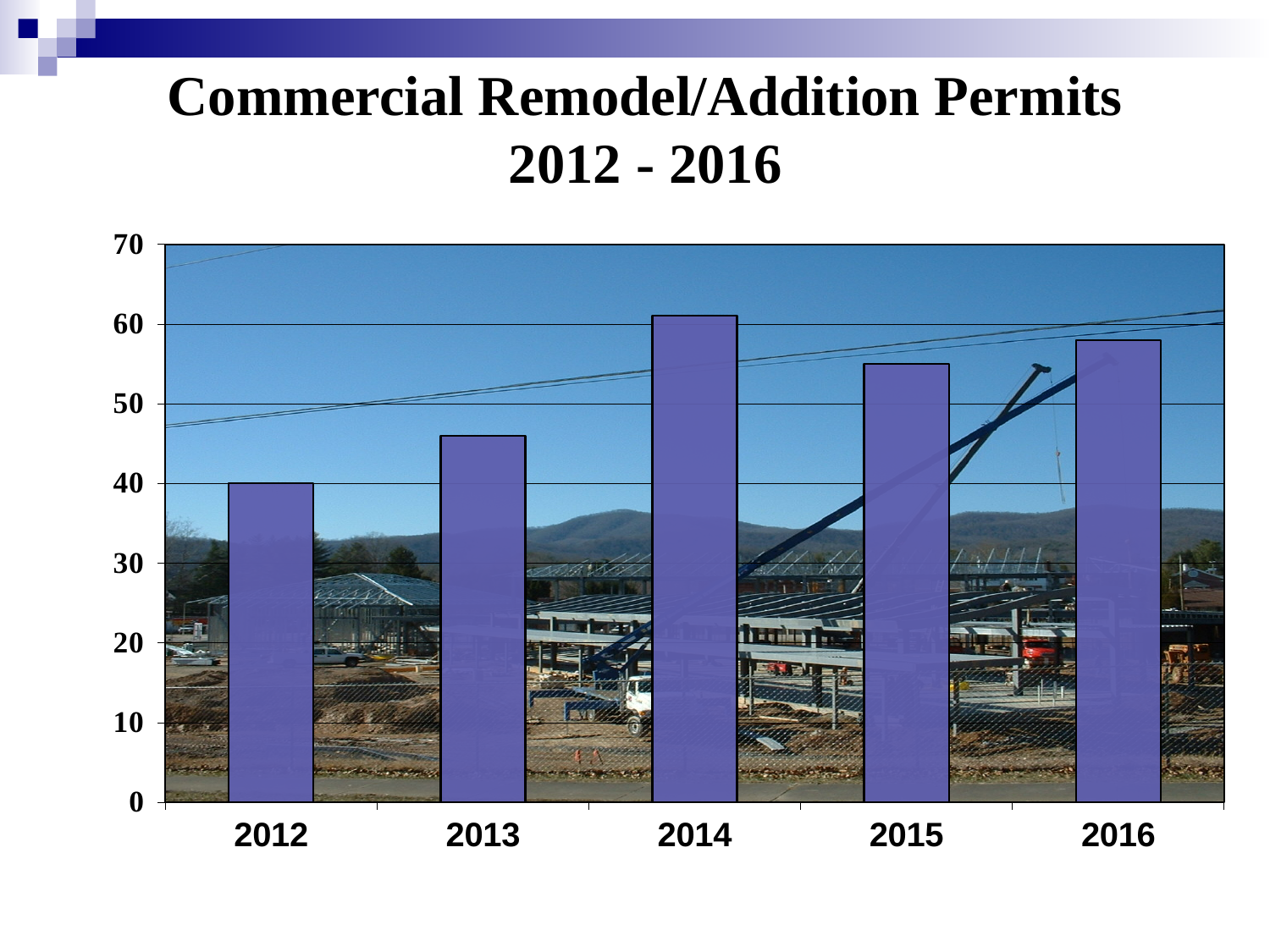
What is the title of the chart? Commercial Remodel/Addition Permits 2012 - 2016 Which year has the highest number of permits? 2014 Do the values rise or fall from 2012 to 2014? rise Which year has the lowest number of permits? 2012 Is the value for 2013 greater or less than 50? less Is the value for 2015 greater or less than 60? less Is the value for 2014 greater or less than 50? greater How many years are shown on the x axis of the chart? 5 Which year has the larger value, 2014 or 2015? 2014 What is the value for 2012? 40 What type of chart is shown on the slide? bar chart